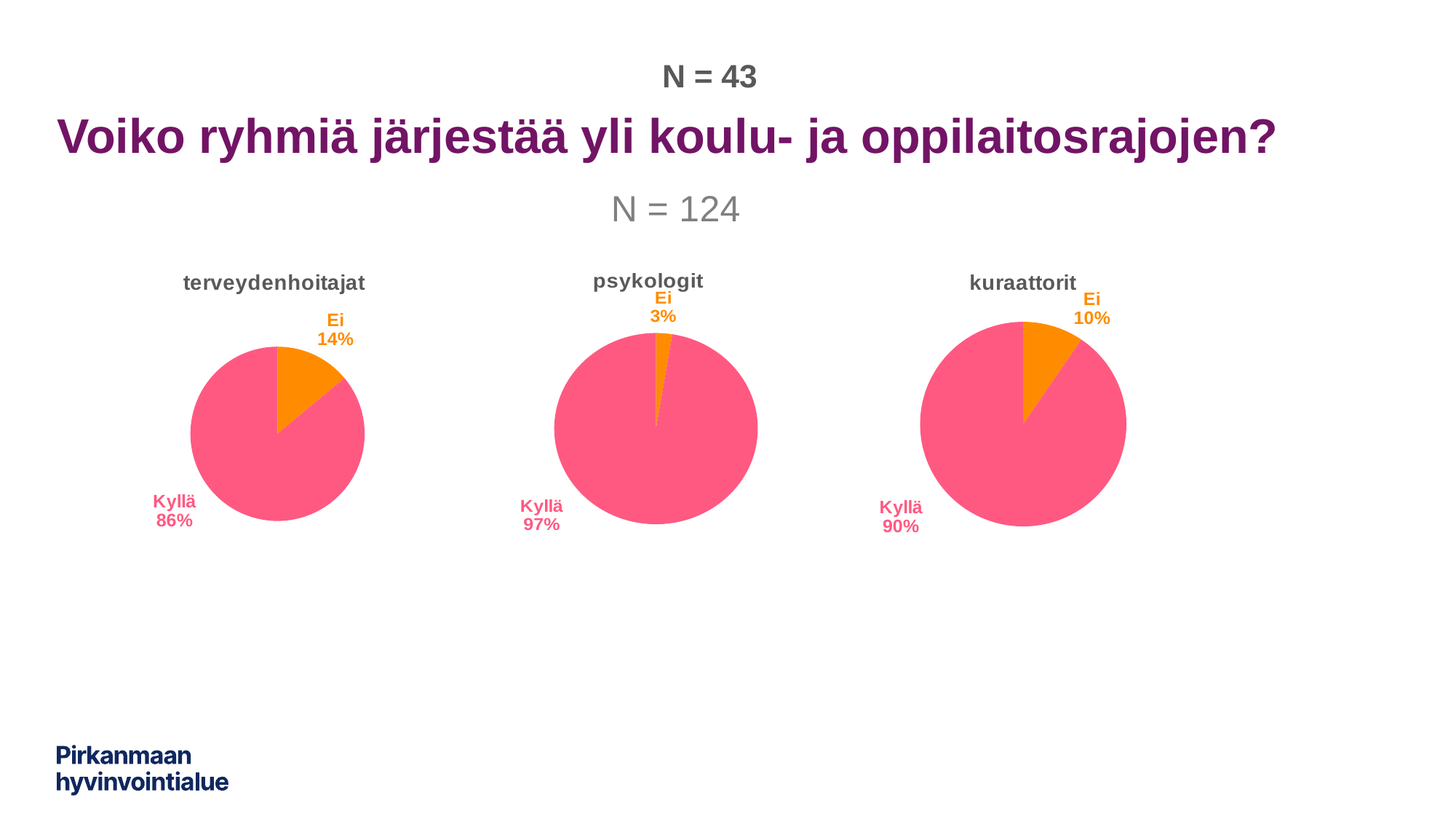
Which of the three pie charts has the largest 'Ei' share? terveydenhoitajat Is the 'Ei' share larger in the 'kuraattorit' chart or in the 'psykologit' chart? kuraattorit How many slices does the 'psykologit' pie chart have? 2 In the 'kuraattorit' pie chart, what share of respondents answered 'Ei'? 10% In the 'psykologit' pie chart, what share of respondents answered 'Kyllä'? 97% Which of the three pie charts has the smallest 'Ei' share? psykologit In the 'psykologit' pie chart, what share of respondents answered 'Ei'? 3% What is the difference between the 'Kyllä' share in the 'psykologit' chart and the 'Kyllä' share in the 'terveydenhoitajat' chart? 11 percentage points What kind of chart is used for the 'kuraattorit' data? Pie chart